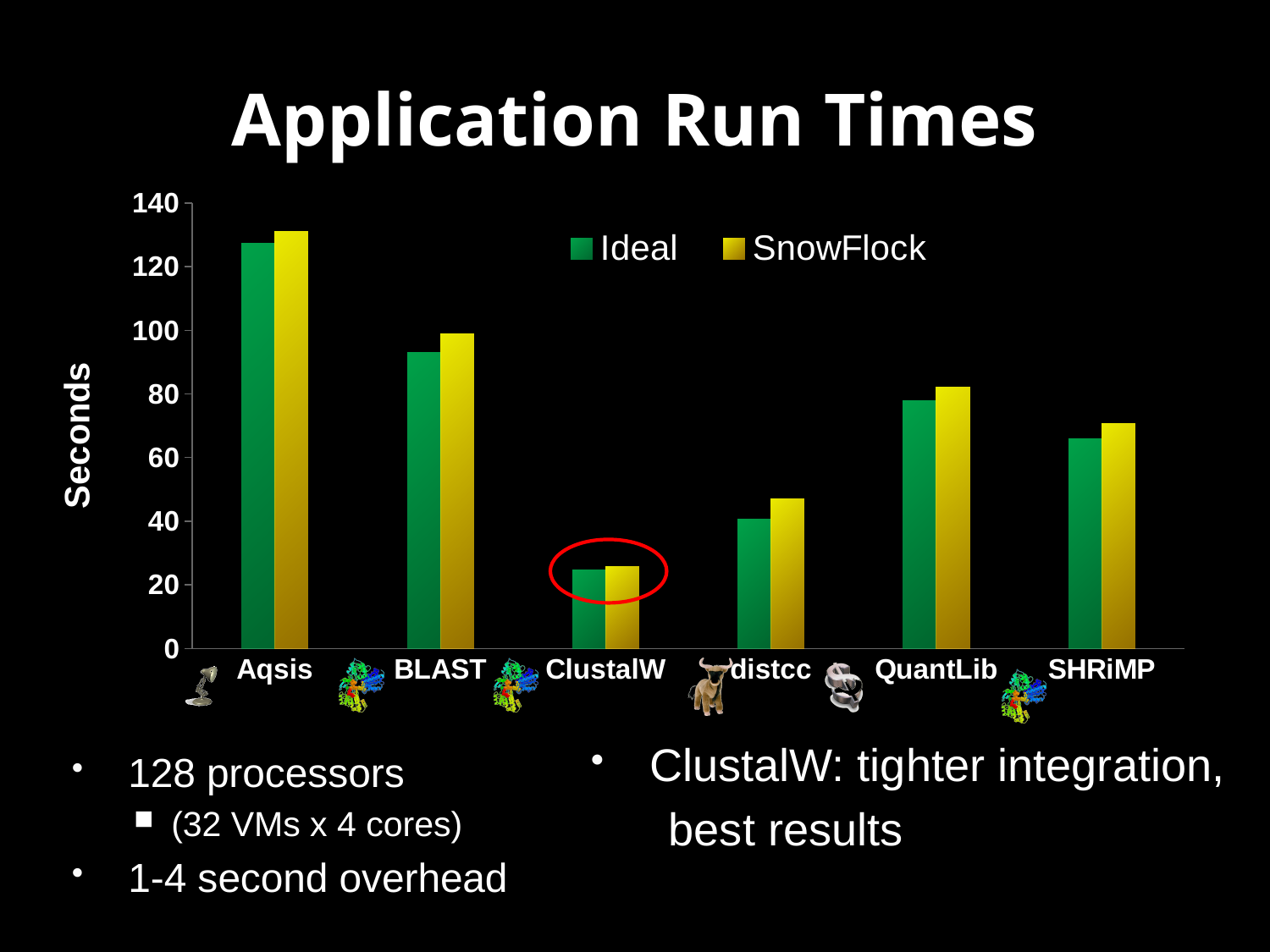
How many applications are shown on the x axis? 6 What kind of chart is shown on the slide? bar chart Is the Ideal value for Aqsis greater or less than 120? greater Which is larger, the Ideal value for BLAST or the Ideal value for QuantLib? BLAST Which application has the lowest SnowFlock run time? ClustalW Is the SnowFlock value for distcc greater or less than 40? greater What is the label of the y axis? Seconds For distcc, which is larger, the Ideal value or the SnowFlock value? SnowFlock How many series does the legend list? 2 Which application has the highest Ideal run time? Aqsis